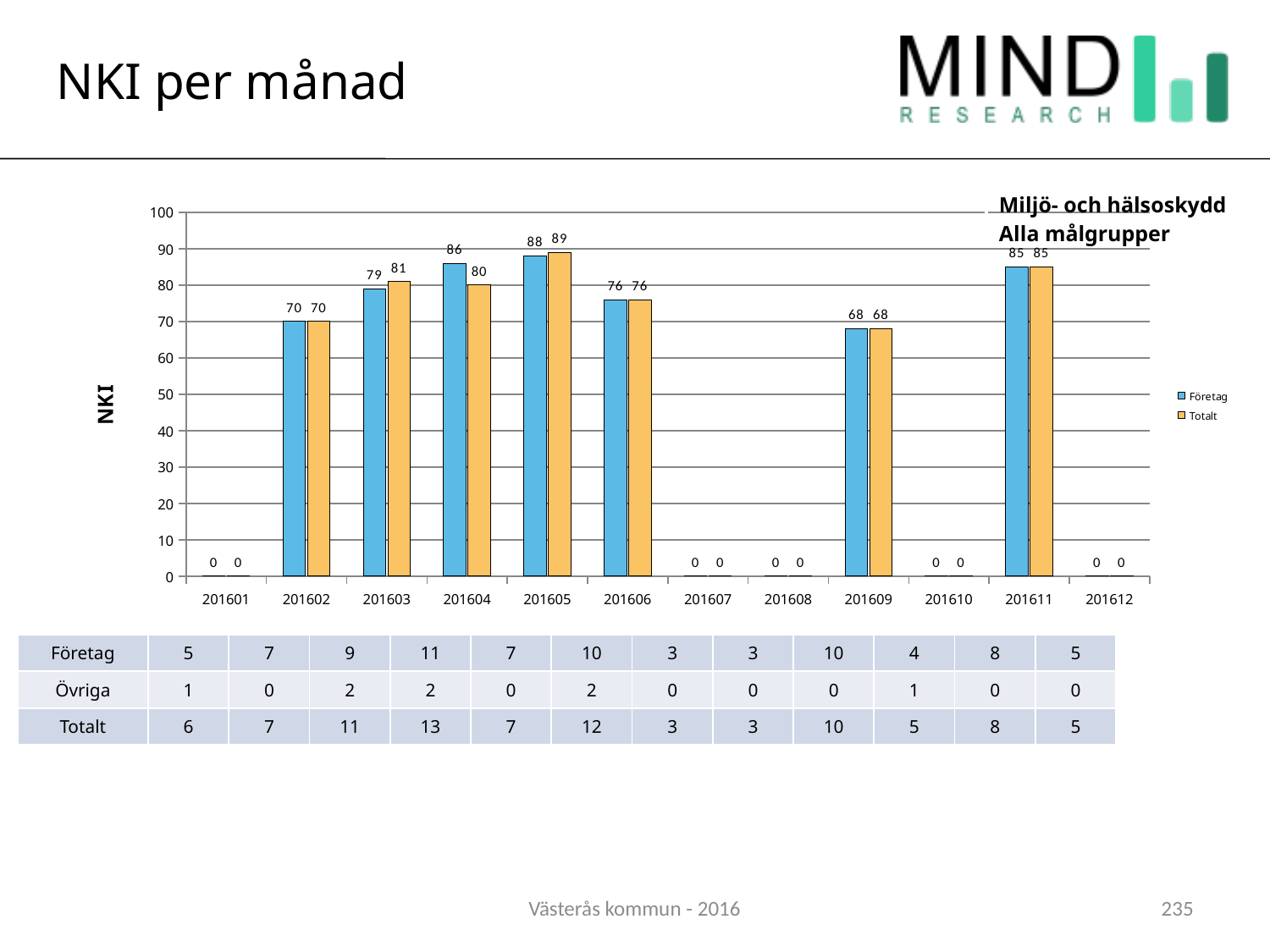
How many series does the legend list? 2 What is the Företag value for 201605? 88 What is the difference between the Företag value for 201605 and the Företag value for 201609? 20 What is the Totalt value for 201604? 80 What is the label on the y axis? NKI Which is larger, the Totalt value for 201603 or the Totalt value for 201604? 201603 Which month has the highest Totalt value? 201605 What is the Totalt value for 201603? 81 Among the months with non-zero values, which month has the lowest Företag value? 201609 How many months are shown on the x axis? 12 Is the Företag value for 201611 greater or less than 80? greater What kind of chart is shown? bar chart